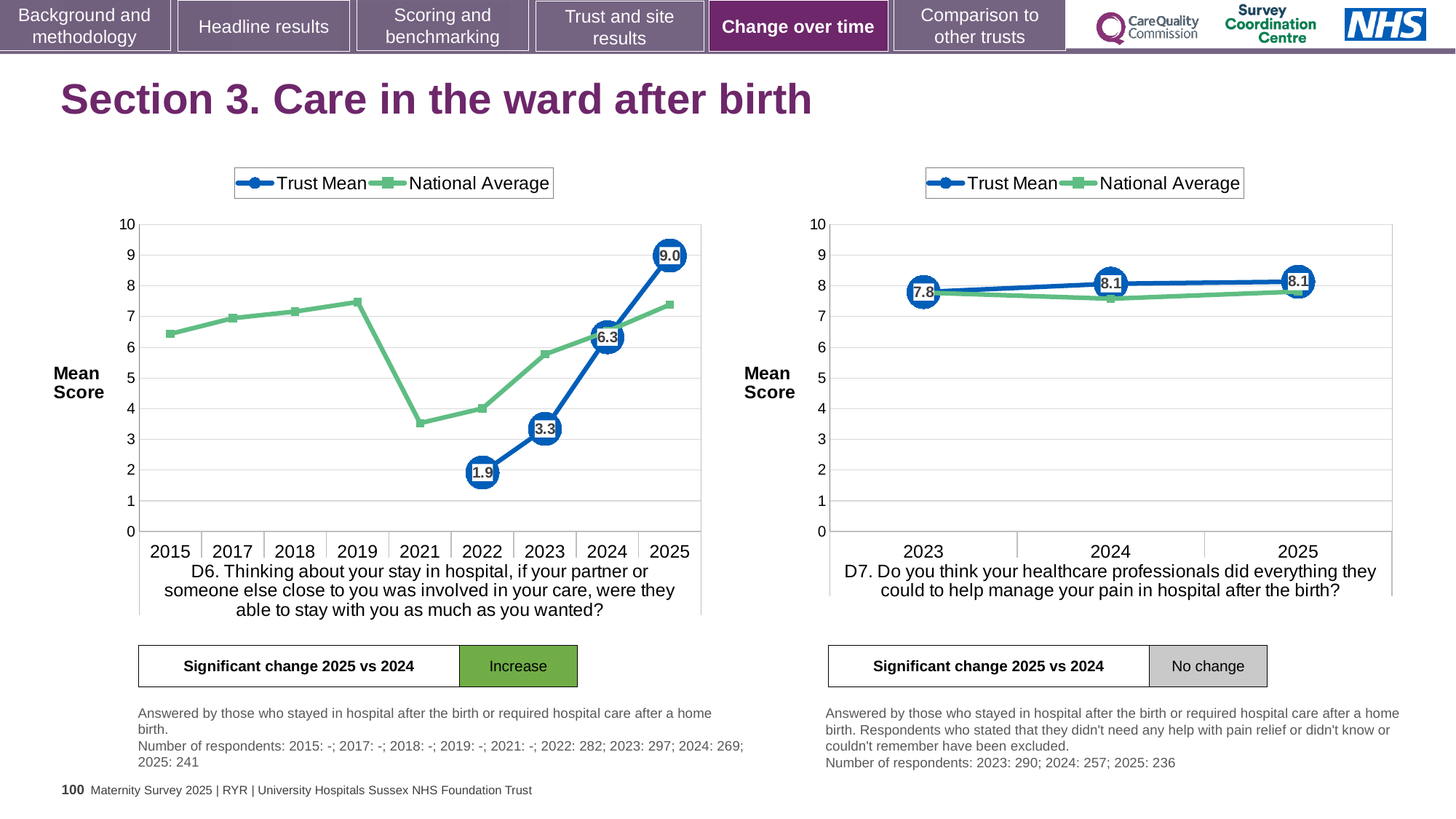
In the right chart (D7), what is the Trust Mean score for 2023? 7.8 In the left chart (D6), what is the Trust Mean score for 2025? 9.0 In the left chart (D6), what is the difference between the Trust Mean scores for 2025 and 2024? 2.7 What kind of chart is the right chart (D7)? line chart In the right chart (D7), how many series does the legend list? 2 In the left chart (D6), which year has the lowest labelled Trust Mean score? 2022 In the left chart (D6), does the Trust Mean rise or fall from 2022 to 2025? rise In the left chart (D6), how many years are shown on the x axis? 9 In the left chart (D6), is the National Average value for 2019 greater or less than 7? greater In the left chart (D6), what is the Trust Mean score for 2022? 1.9 In the right chart (D7), which series is drawn in green? National Average In the right chart (D7), what is the difference between the Trust Mean scores for 2024 and 2023? 0.3